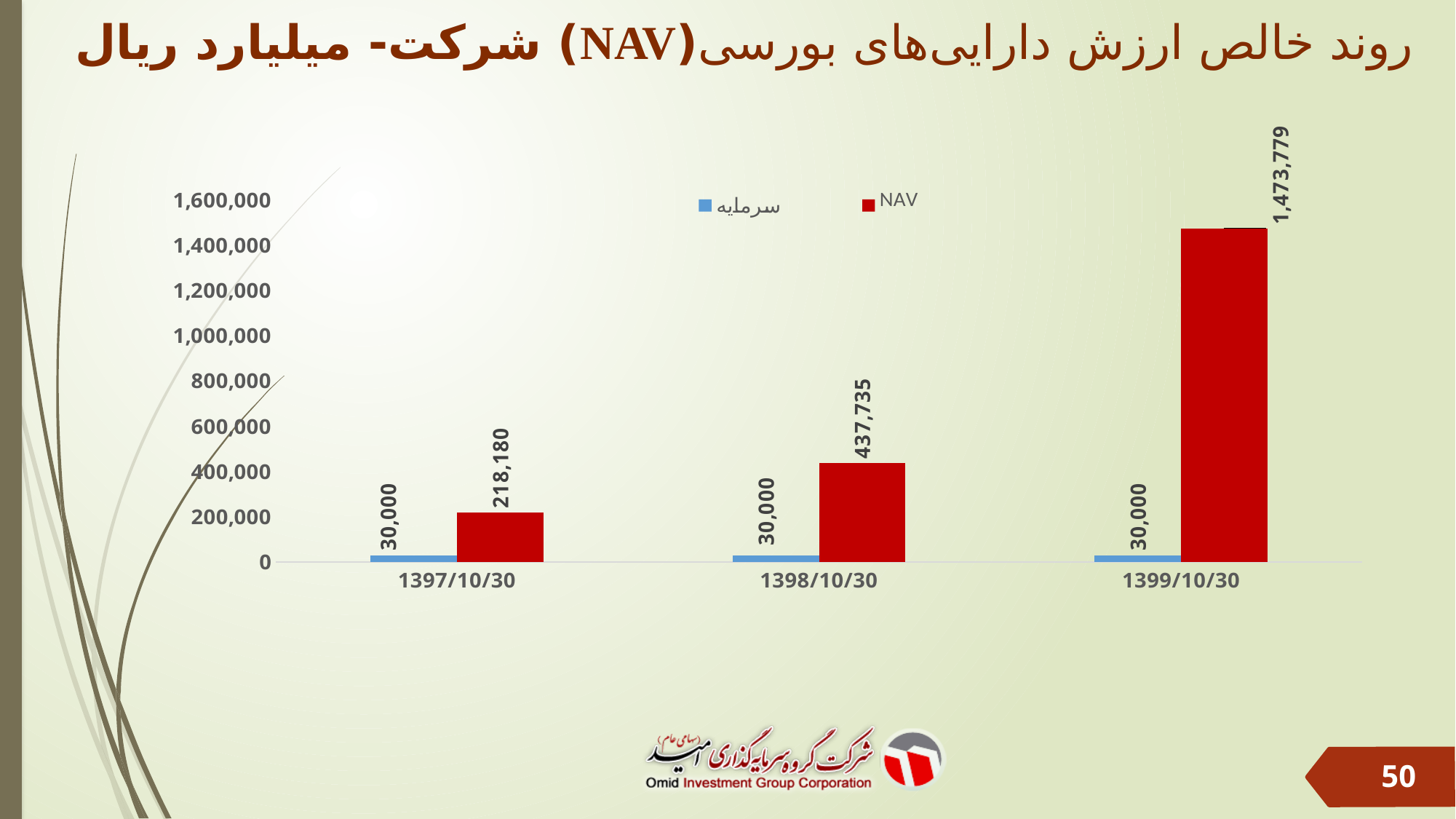
What is the NAV value for 1399/10/30? 1,473,779 What kind of chart is shown on the slide? bar chart Which is larger, the NAV value for 1398/10/30 or the NAV value for 1399/10/30? 1399/10/30 How many dates are shown on the x axis? 3 Is the NAV value for 1398/10/30 greater or less than 400,000? greater How many series does the legend list? 2 What is the difference between the NAV values for 1398/10/30 and 1397/10/30? 219,555 Which date has the highest NAV value? 1399/10/30 What is the NAV value for 1397/10/30? 218,180 Does the NAV value rise or fall from 1397/10/30 to 1399/10/30? rise Which date has the lowest NAV value? 1397/10/30 What is the سرمایه value for 1398/10/30? 30,000